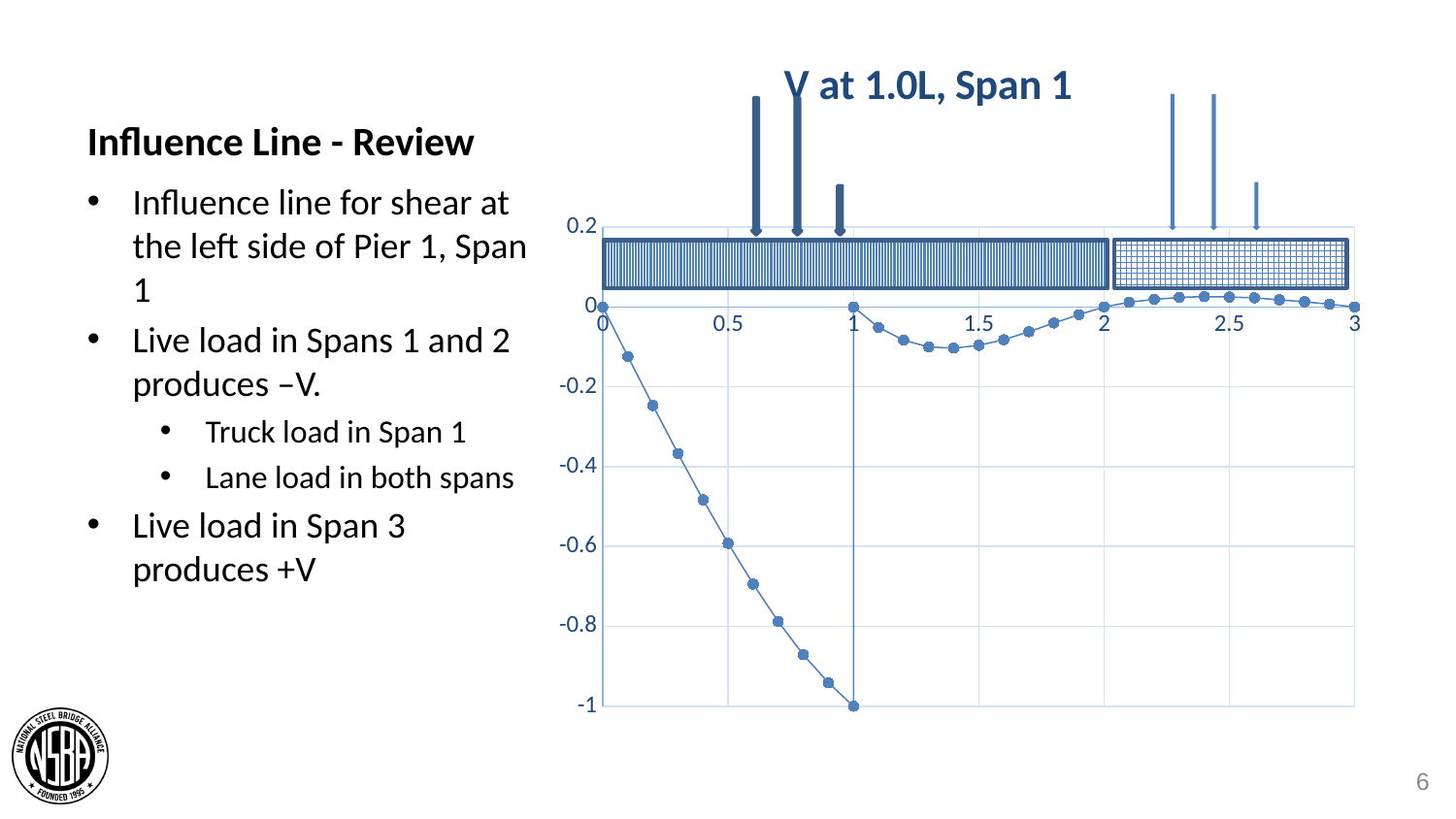
What kind of chart is shown on the slide? line chart What is the title of the chart? V at 1.0L, Span 1 What is the plotted value at x = 0? 0 Which is larger, the plotted value at x = 0.5 or at x = 1.5? x = 1.5 Is the plotted value at x = 1.5 greater or less than -0.2? greater Is the plotted value at x = 0.5 greater or less than -0.2? less Is the plotted value at x = 2.5 greater or less than 0? greater Do the plotted values rise or fall as x goes from 0 to 1? fall What is the lowest value plotted on the chart? -1 At which x value does the chart reach its lowest point? 1 What is the highest tick label shown on the y axis? 0.2